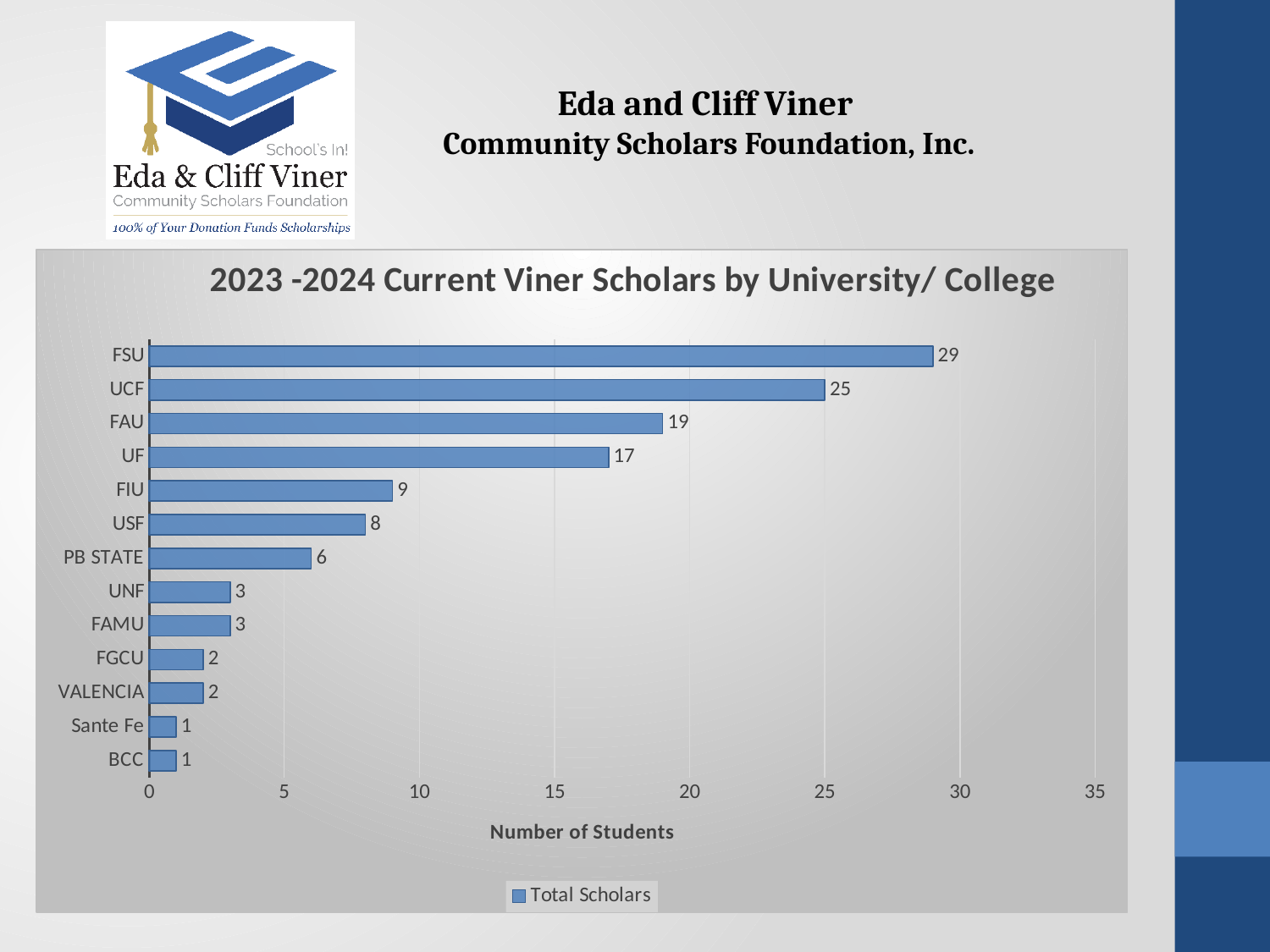
What is the difference in number of students between UCF and FAU? 6 Is the value for UCF greater or less than 20? greater What is the number of students for UF? 17 How many universities/colleges are listed on the chart? 13 Which has more scholars, FIU or USF? FIU How many Viner scholars does FSU have? 29 What kind of chart is shown on the slide? bar chart What is the title of the chart? 2023 -2024 Current Viner Scholars by University/ College How many series does the legend list? 1 Which university has the highest number of Viner scholars? FSU What is the label of the horizontal axis? Number of Students How many scholars are shown for PB STATE? 6